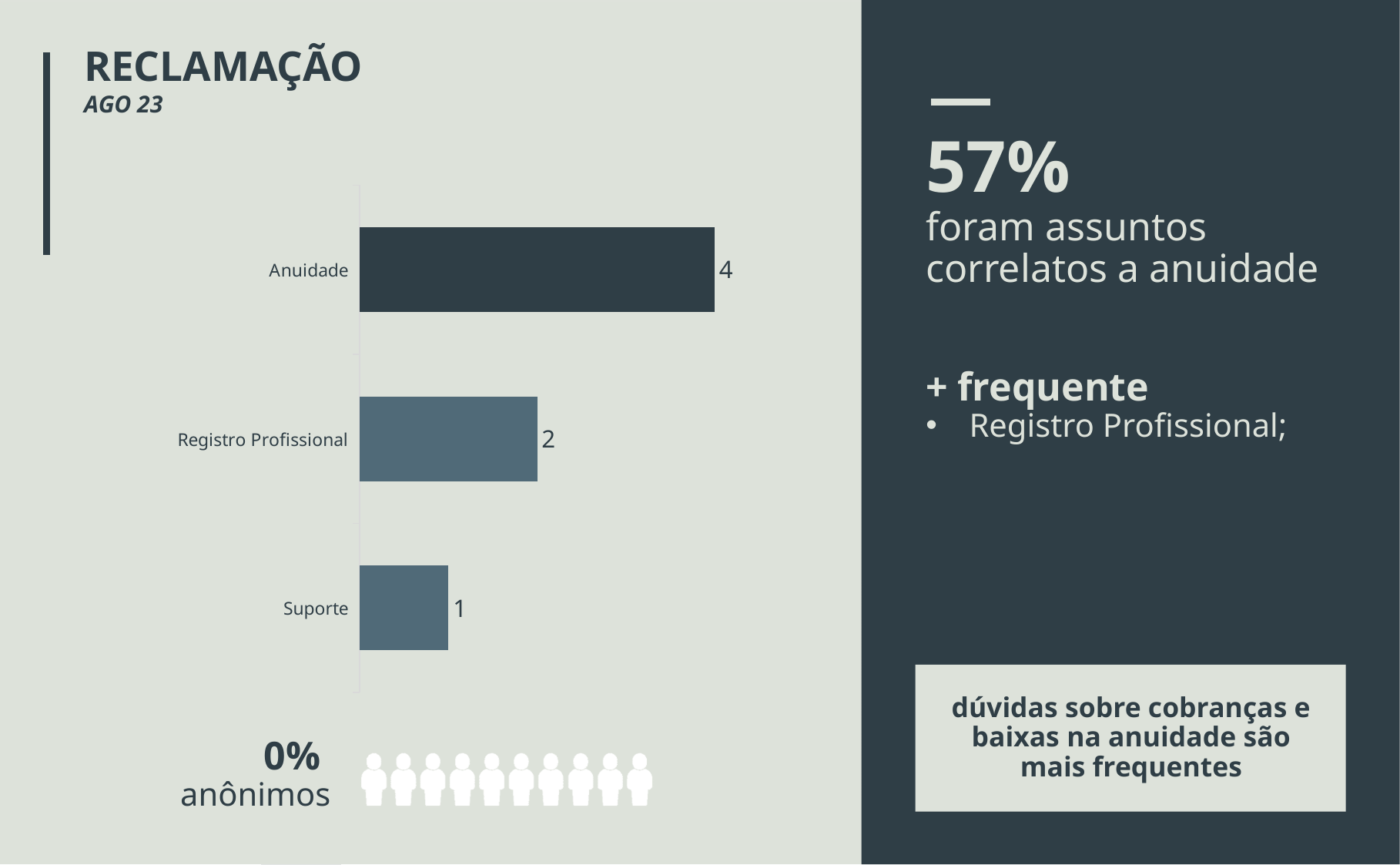
What is the difference between the values for Registro Profissional and Suporte? 1 Which is larger, the value for Anuidade or the value for Suporte? Anuidade Which category has the lowest value? Suporte What is the total of the three values shown in the chart? 7 What is the value for Suporte? 1 What is the title of the slide containing the chart? RECLAMAÇÃO How many categories are shown in the chart? 3 What is the value for Registro Profissional? 2 Which category has the highest value? Anuidade What is the value for Anuidade? 4 What kind of chart is shown on the slide? Bar chart What is the difference between the values for Anuidade and Registro Profissional? 2